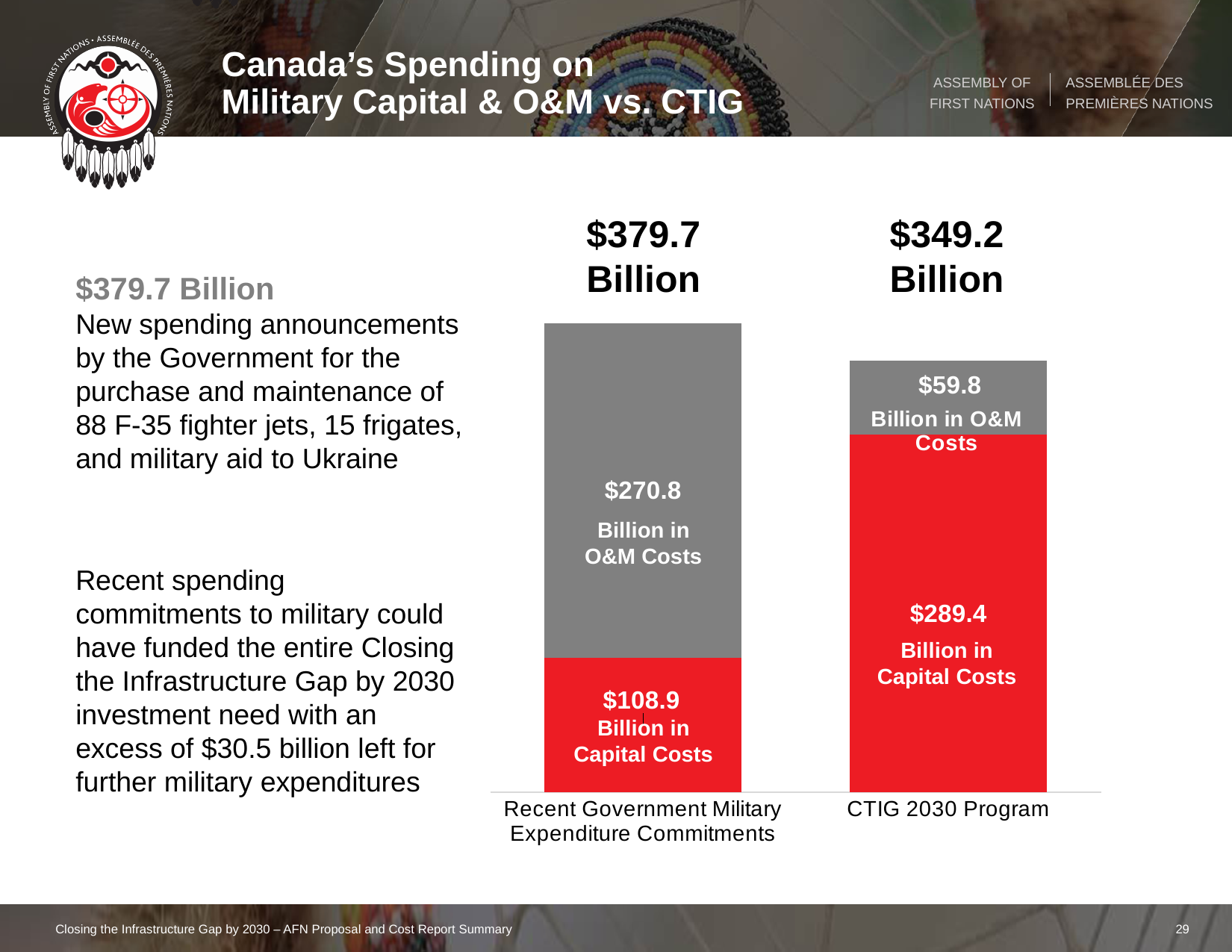
What type of chart is shown on the slide? Stacked bar chart What is the total of the stacked bar for the CTIG 2030 Program? $349.2 Billion How many categories are shown on the x axis of the chart? 2 What is the total of the stacked bar for Recent Government Military Expenditure Commitments? $379.7 Billion What is the difference between O&M Costs for Recent Government Military Expenditure Commitments and O&M Costs for the CTIG 2030 Program? $211.0 Billion Which category has the higher total, Recent Government Military Expenditure Commitments or CTIG 2030 Program? Recent Government Military Expenditure Commitments What is the value of O&M Costs for Recent Government Military Expenditure Commitments? $270.8 Billion Which category has the larger Capital Costs value? CTIG 2030 Program What is the value of Capital Costs for Recent Government Military Expenditure Commitments? $108.9 Billion What is the value of O&M Costs for the CTIG 2030 Program? $59.8 Billion What is the value of Capital Costs for the CTIG 2030 Program? $289.4 Billion What is the difference between the total for Recent Government Military Expenditure Commitments and the total for the CTIG 2030 Program? $30.5 Billion